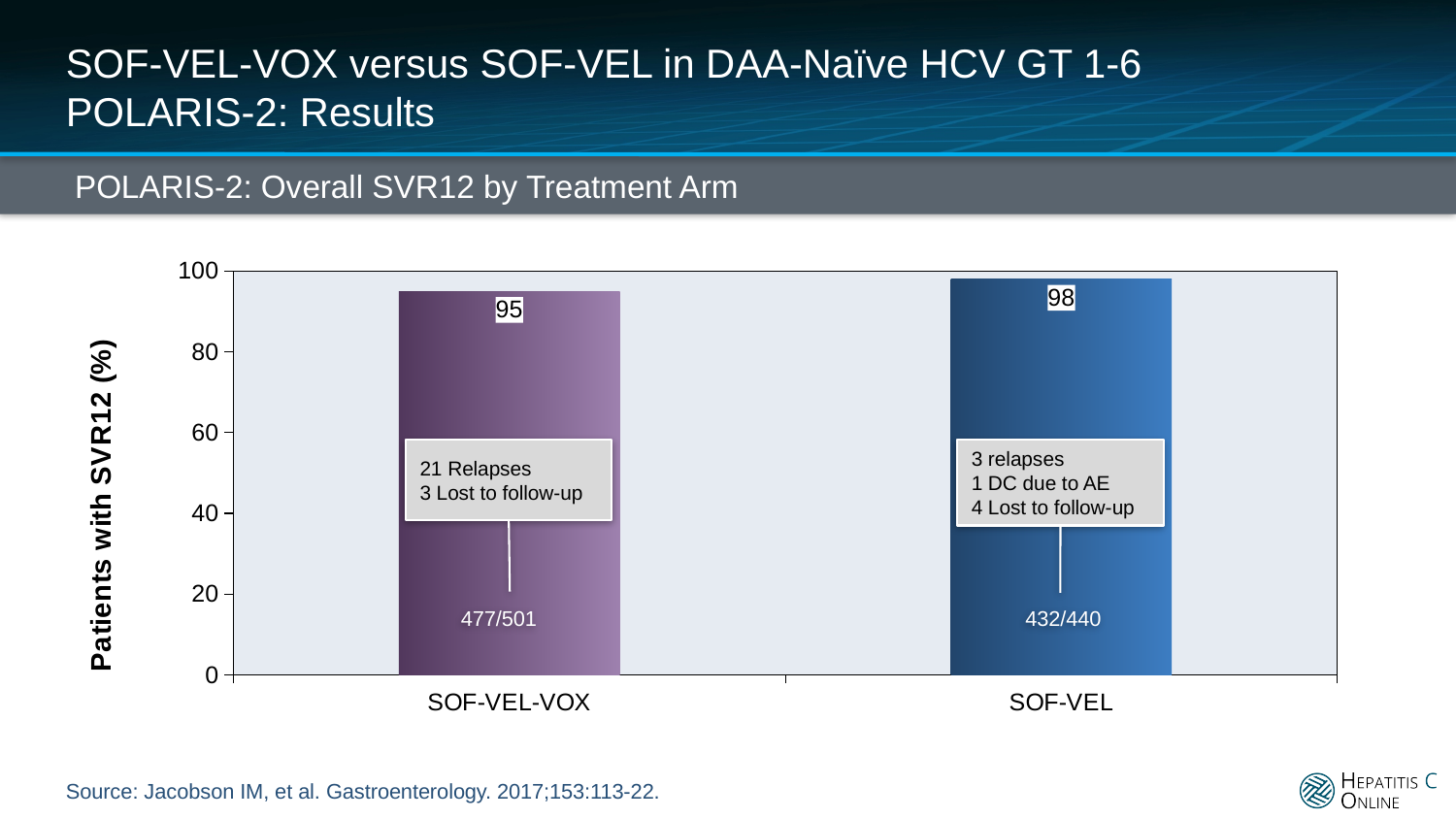
What is the difference in SVR12 rate between SOF-VEL and SOF-VEL-VOX? 3 What fraction of patients achieved SVR12 in the SOF-VEL-VOX arm? 477/501 Which treatment arm has the lower SVR12 rate? SOF-VEL-VOX What is the title of the chart? POLARIS-2: Overall SVR12 by Treatment Arm Which treatment arm has the higher SVR12 rate? SOF-VEL What kind of chart is shown on the slide? Bar chart What is the SVR12 rate for the SOF-VEL arm? 98 Is the SVR12 rate for SOF-VEL-VOX greater or less than 80? greater What is the SVR12 rate for the SOF-VEL-VOX arm? 95 How many relapses were reported in the SOF-VEL-VOX arm? 21 What fraction of patients achieved SVR12 in the SOF-VEL arm? 432/440 How many treatment arms are shown on the x axis? 2